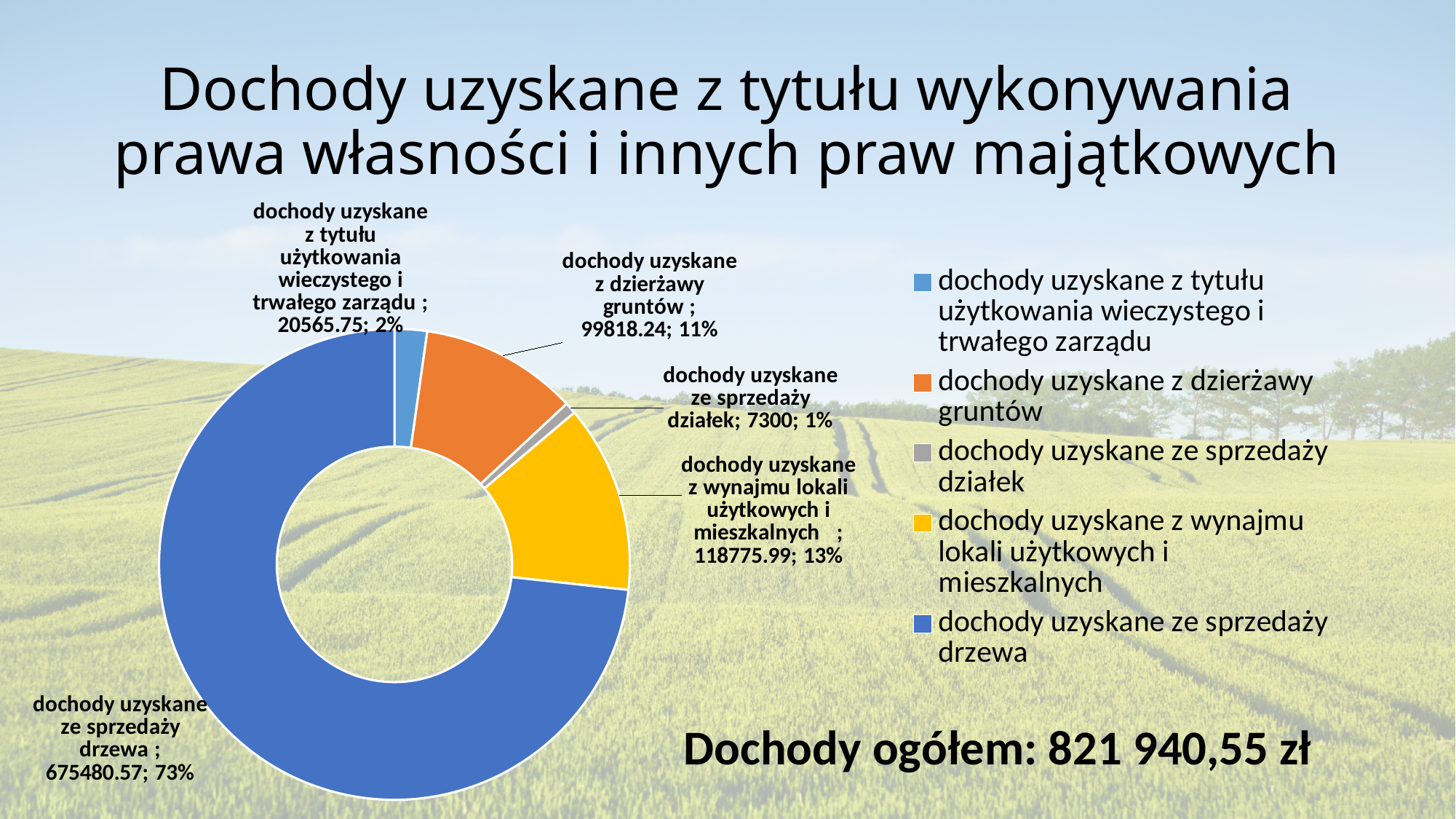
What is the value for 'dochody uzyskane z dzierżawy gruntów'? 99818.24 What is the value for 'dochody uzyskane ze sprzedaży drzewa'? 675480.57 What is the value for 'dochody uzyskane z wynajmu lokali użytkowych i mieszkalnych'? 118775.99 How many categories does the chart show? 5 What is the value for 'dochody uzyskane ze sprzedaży działek'? 7300 Which category has the smallest share of the chart? dochody uzyskane ze sprzedaży działek What type of chart is shown on the slide? Doughnut chart What is the difference between the values for 'dochody uzyskane z wynajmu lokali użytkowych i mieszkalnych' and 'dochody uzyskane z dzierżawy gruntów'? 18957.75 Which category has the largest share of the chart? dochody uzyskane ze sprzedaży drzewa Which is larger: the value for 'dochody uzyskane z dzierżawy gruntów' or 'dochody uzyskane z tytułu użytkowania wieczystego i trwałego zarządu'? dochody uzyskane z dzierżawy gruntów What share of the chart does 'dochody uzyskane z wynajmu lokali użytkowych i mieszkalnych' represent? 13% What share of the chart does 'dochody uzyskane z tytułu użytkowania wieczystego i trwałego zarządu' represent? 2%